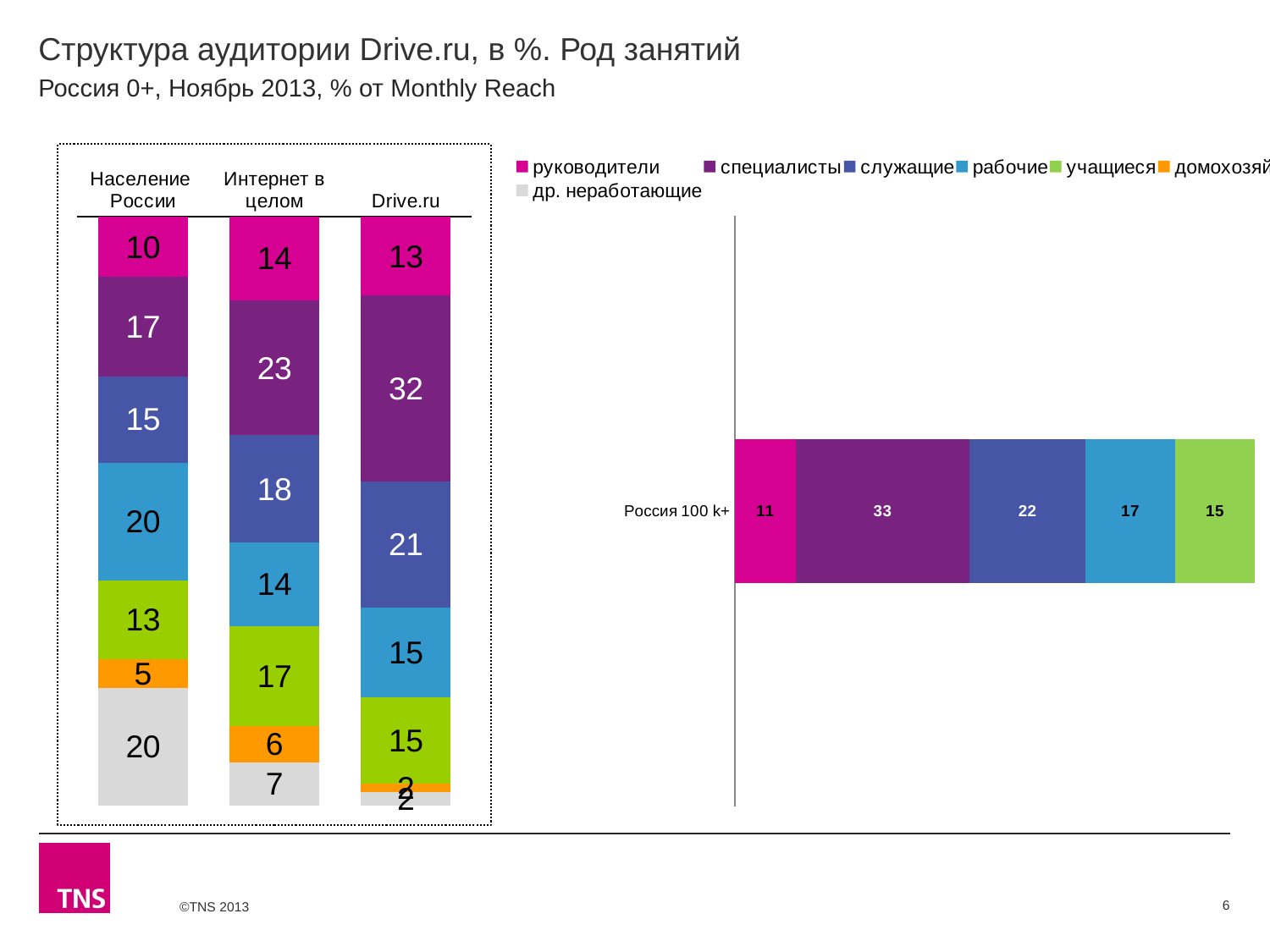
How many columns (categories) are shown in the left stacked bar chart? 3 In the right chart (Россия 100 k+), which segment is the smallest? руководители In the right chart (Россия 100 k+), what is the value for специалисты? 33 In the left stacked bar chart, what is the value for служащие in the Интернет в целом column? 18 In the left stacked bar chart, what is the value for специалисты in the Drive.ru column? 32 What type of chart is used on this slide? Stacked bar chart In the right chart (Россия 100 k+), which segment is the largest? специалисты In the left stacked bar chart, what is the difference between the специалисты values for Drive.ru and Интернет в целом? 9 In the left stacked bar chart, which is larger for учащиеся: Интернет в целом or Население России? Интернет в целом In the right chart (Россия 100 k+), what is the difference between the служащие and рабочие values? 5 In the left stacked bar chart, which column has the highest value for специалисты? Drive.ru In the left stacked bar chart, what is the value for рабочие in the Население России column? 20